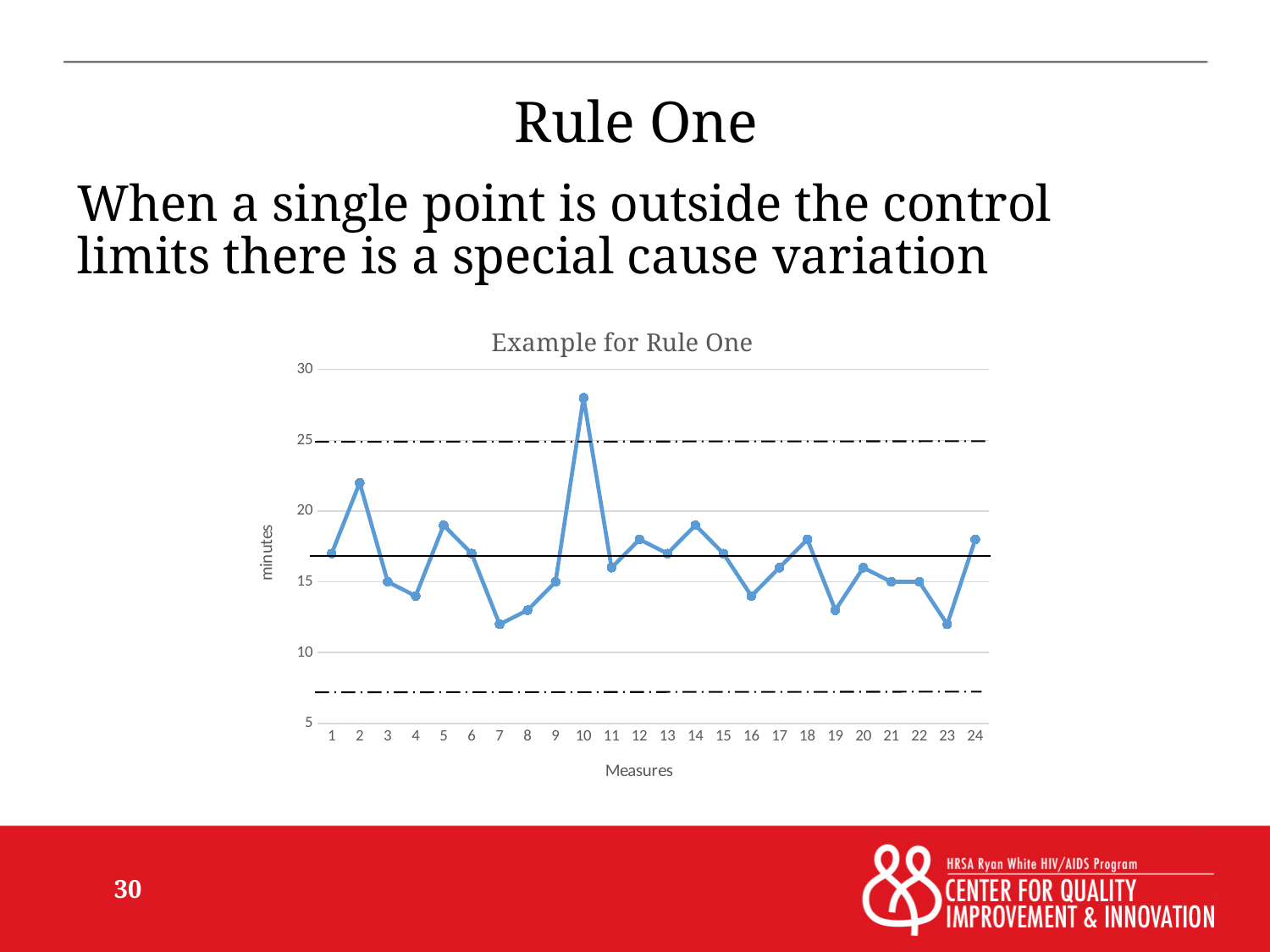
What is the title of the chart? Example for Rule One Is the value for measure 10 greater or less than 25? greater Is the value for measure 23 greater or less than 15? less Which has the larger value, measure 10 or measure 14? measure 10 What kind of chart is shown on the slide? line chart What is the label of the x axis of the chart? Measures Is the value for measure 7 greater or less than 15? less Which has the larger value, measure 2 or measure 3? measure 2 How many measures (data points) are plotted on the chart? 24 Which measure has the highest value on the chart? 10